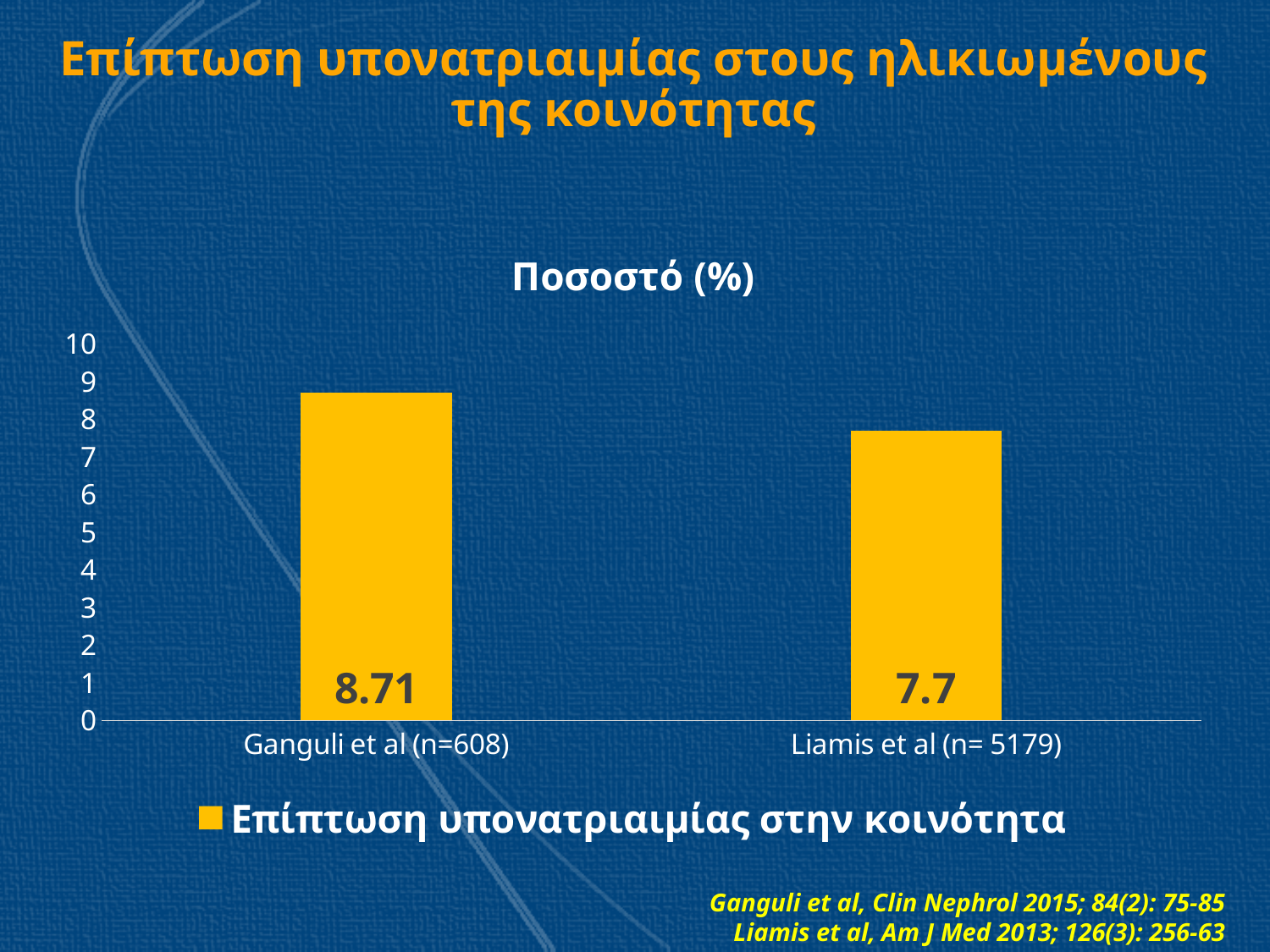
Which category has the lowest value? Liamis et al (n= 5179) How many series does the legend list? 1 What is the title of the chart? Ποσοστό (%) What is the value for Liamis et al (n= 5179)? 7.7 What is the difference between the values for Ganguli et al (n=608) and Liamis et al (n= 5179)? 1.01 Is the value for Liamis et al (n= 5179) greater or less than 8? less Which category has the highest value? Ganguli et al (n=608) Is the value for Ganguli et al (n=608) greater or less than 8? greater Which is larger, the value for Ganguli et al (n=608) or the value for Liamis et al (n= 5179)? Ganguli et al (n=608) What is the value for Ganguli et al (n=608)? 8.71 How many categories are shown on the x axis? 2 What kind of chart is shown on the slide? bar chart